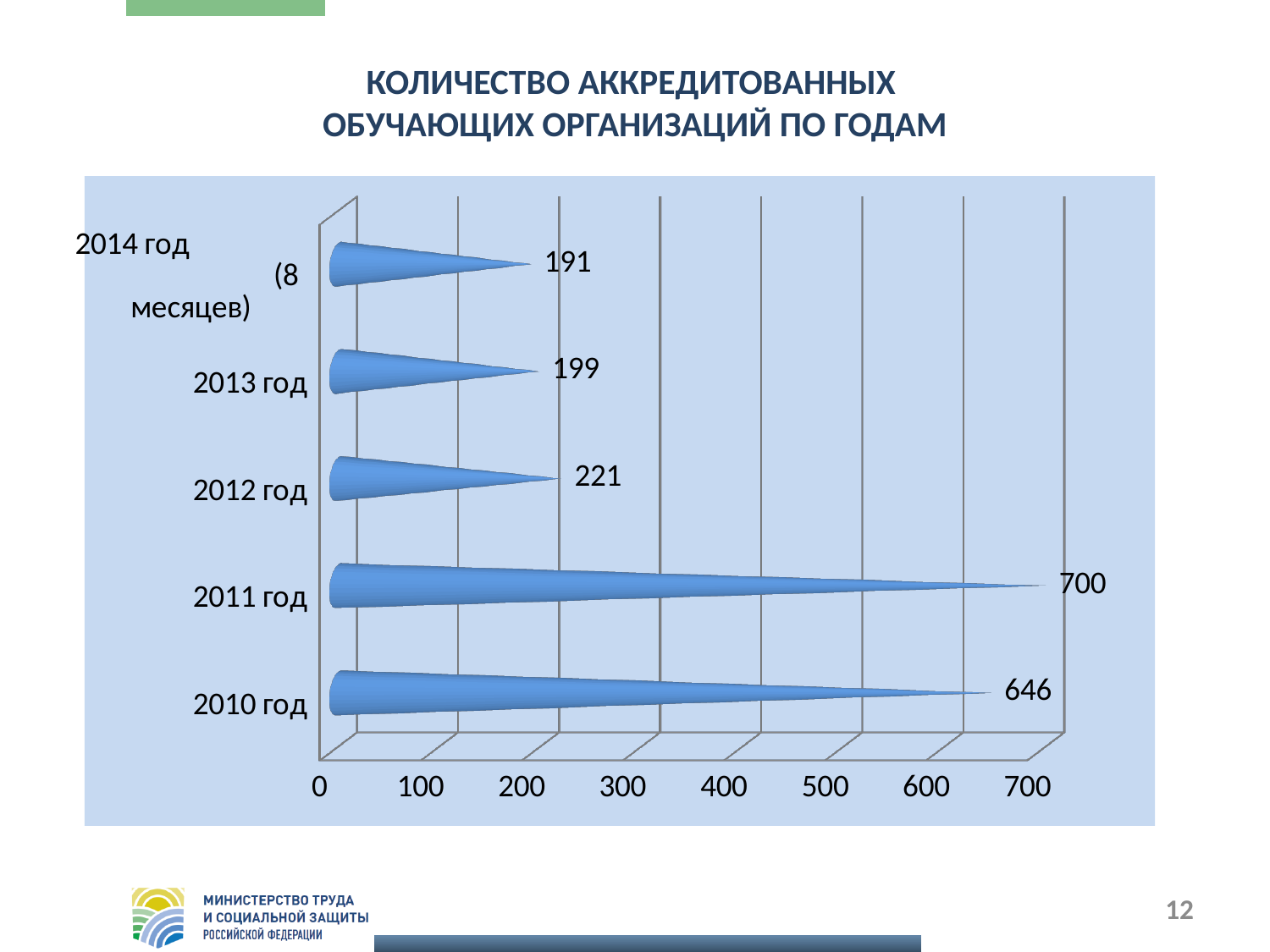
What is the difference between the values for 2012 год and 2013 год? 22 Is the value for 2013 год greater or less than 300? less Which year has the highest value? 2011 год What is the value for 2011 год? 700 Which category has the lowest value? 2014 год (8 месяцев) What is the value for 2014 год (8 месяцев)? 191 What kind of chart is shown on the slide? bar chart What is the title of the chart? КОЛИЧЕСТВО АККРЕДИТОВАННЫХ ОБУЧАЮЩИХ ОРГАНИЗАЦИЙ ПО ГОДАМ How many categories are shown in the chart? 5 What is the difference between the values for 2011 год and 2010 год? 54 What is the value for 2012 год? 221 Which is larger, the value for 2010 год or the value for 2012 год? 2010 год